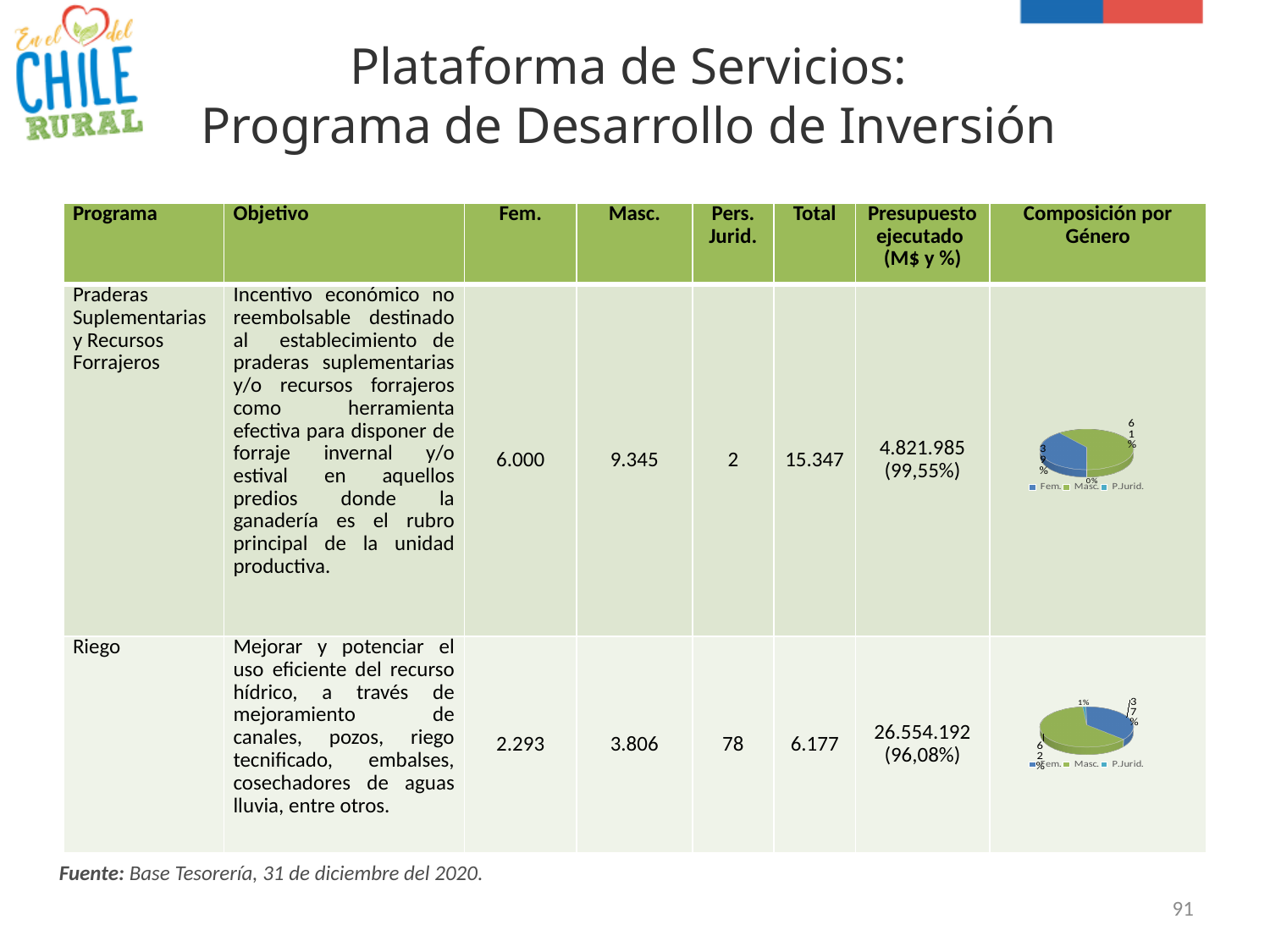
In the pie chart for the Praderas Suplementarias y Recursos Forrajeros row, which category has the smallest slice? P.Jurid. In the pie chart for the Praderas Suplementarias y Recursos Forrajeros row, what share is shown for Masc.? 61% In the pie chart for the Riego row, which category has the largest slice? Masc. In the pie chart for the Praderas Suplementarias y Recursos Forrajeros row, which category has the largest slice? Masc. What are the legend entries of the pie chart in the Riego row? Fem., Masc., P.Jurid. What kind of chart is shown in the 'Composición por Género' column for the Praderas Suplementarias y Recursos Forrajeros row? Pie chart In the pie chart for the Riego row, is the Masc. slice larger or smaller than the Fem. slice? Larger In the pie chart for the Praderas Suplementarias y Recursos Forrajeros row, what share is shown for P.Jurid.? 0% What kind of chart is shown in the 'Composición por Género' column for the Riego row? Pie chart In the pie chart for the Riego row, what share is shown for P.Jurid.? 1% How many entries does the legend of the pie chart in the Praderas Suplementarias y Recursos Forrajeros row list? 3